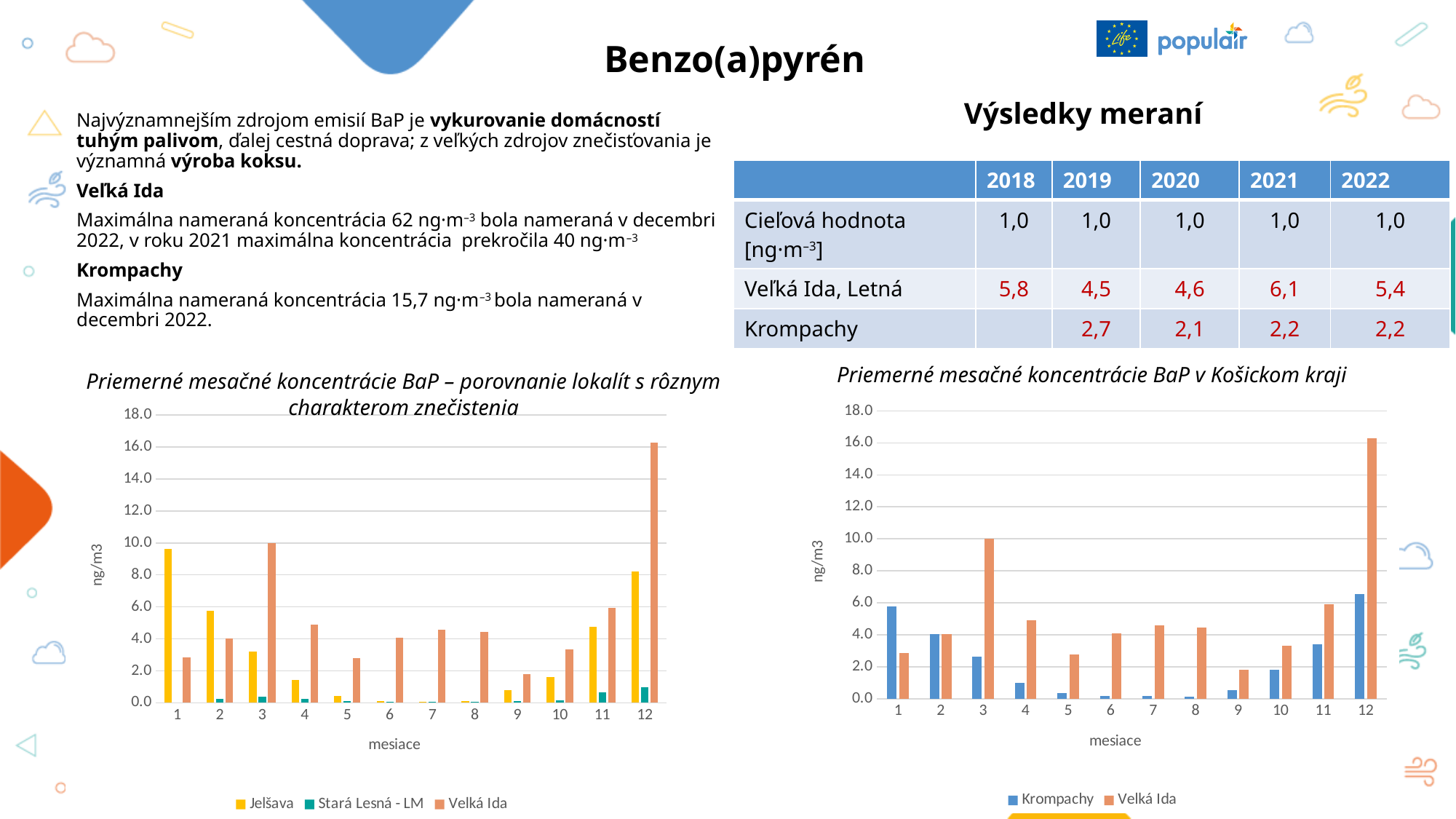
In the left chart, in which month is the Veľká Ida value highest? 12 What is the y-axis label of the right chart? ng/m3 How many series does the legend of the right chart 'Priemerné mesačné koncentrácie BaP v Košickom kraji' list? 2 In the left chart, in which month is the Jelšava value highest? 1 In the left chart, which is larger in month 3: Jelšava or Veľká Ida? Veľká Ida In the left chart, is the Veľká Ida value for month 12 greater or less than 14.0? greater In the right chart, which is larger in month 1: Krompachy or Veľká Ida? Krompachy How many series does the legend of the left chart list? 3 What type of chart is the left chart titled 'Priemerné mesačné koncentrácie BaP – porovnanie lokalít s rôznym charakterom znečistenia'? bar chart How many months are shown on the x axis of the left chart? 12 In the left chart, in which month is the Veľká Ida value lowest? 9 In the right chart, in which month is the Krompachy value highest? 12